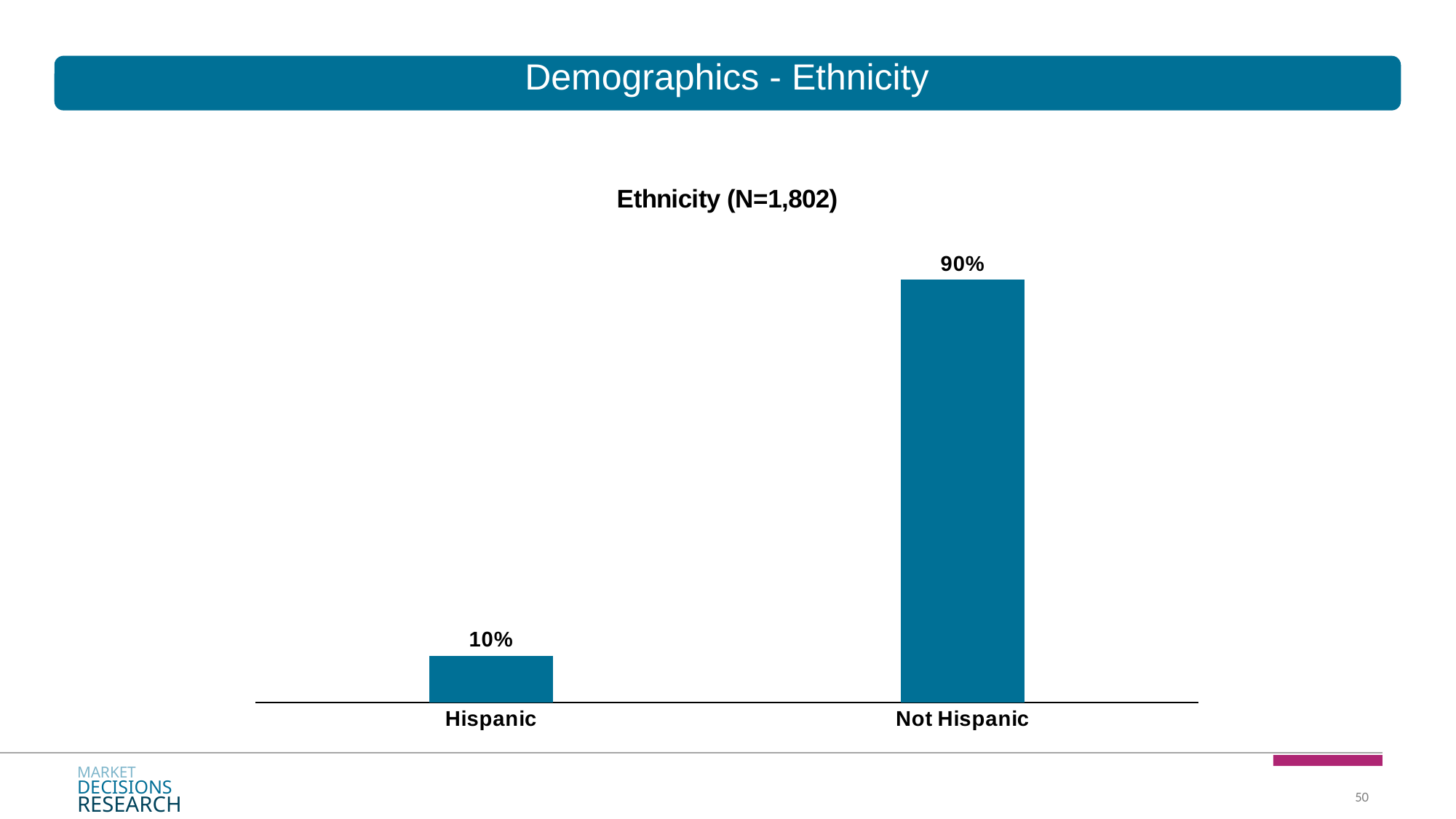
How many categories are shown in the chart? 2 What is the value for Not Hispanic? 90% What is the difference between the values for Not Hispanic and Hispanic? 80% What is the value for Hispanic? 10% What is the total of the two values shown in the chart? 100% What kind of chart is shown on the slide? Bar chart What is the title of the chart? Ethnicity (N=1,802) Which category has the lowest value? Hispanic Which is larger, the value for Hispanic or the value for Not Hispanic? Not Hispanic Which category has the highest value? Not Hispanic What is the sample size (N) shown in the chart title? 1,802